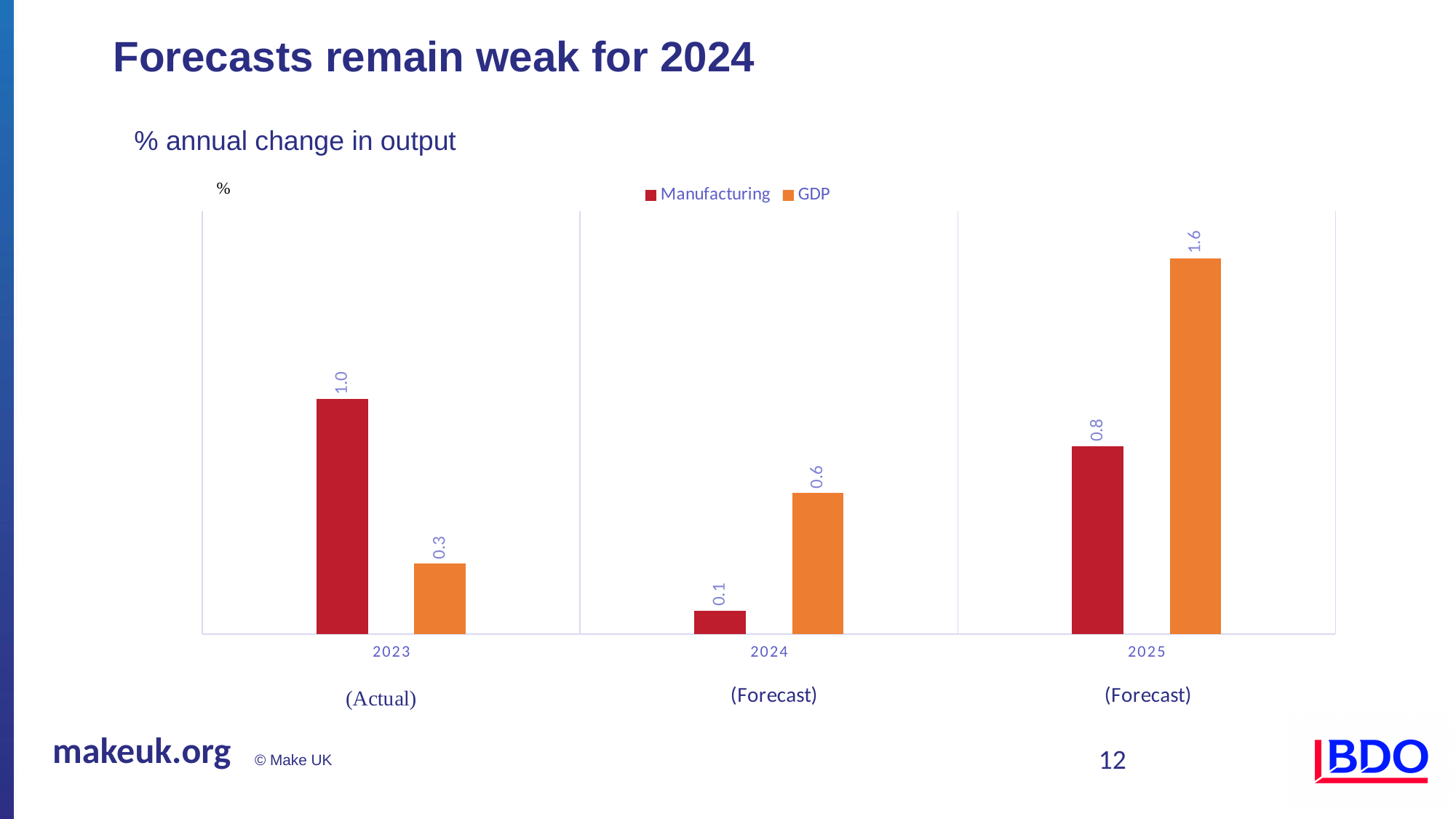
What is the Manufacturing value for 2023? 1.0 What is the Manufacturing value for 2025? 0.8 What kind of chart is shown on the slide? Bar chart Does the GDP value rise or fall from 2023 to 2025? Rise How many years are shown on the x axis? 3 What is the GDP value for 2024? 0.6 Which year has the highest GDP value? 2025 How many series does the legend list? 2 What is the difference between the GDP and Manufacturing values for 2025? 0.8 Which is larger in 2023, Manufacturing or GDP? Manufacturing Which year has the lowest Manufacturing value? 2024 Which series is shown in orange in the legend? GDP